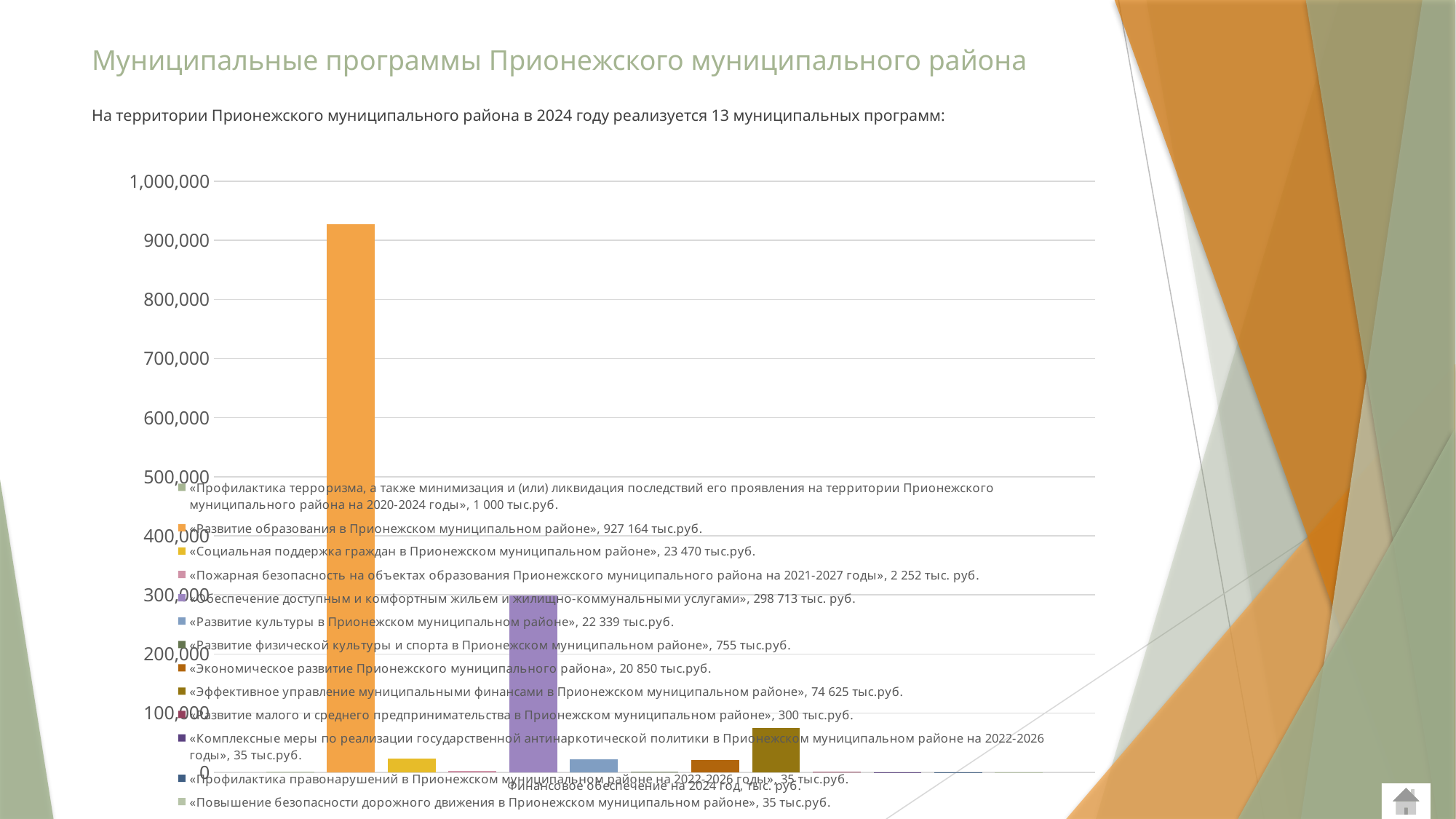
What is the title of the slide containing the chart? Муниципальные программы Прионежского муниципального района What is the financial provision for the programme «Развитие образования в Прионежском муниципальном районе»? 927 164 тыс.руб. What is the label on the x axis of the chart? Финансовое обеспечение на 2024 год, тыс. руб. What is the financial provision for the programme «Эффективное управление муниципальными финансами в Прионежском муниципальном районе»? 74 625 тыс.руб. What is the financial provision for the programme «Обеспечение доступным и комфортным жильем и жилищно-коммунальными услугами»? 298 713 тыс. руб. Is the bar for «Развитие образования в Прионежском муниципальном районе» greater or less than 900,000? greater What is the difference between the financial provision for «Развитие образования» (927 164) and «Обеспечение доступным и комфортным жильем» (298 713)? 628 451 тыс.руб. What is the financial provision for the programme «Социальная поддержка граждан в Прионежском муниципальном районе»? 23 470 тыс.руб. Which has the larger financial provision: «Социальная поддержка граждан» or «Развитие культуры»? «Социальная поддержка граждан» Which programme has the highest financial provision for 2024? «Развитие образования в Прионежском муниципальном районе» How many series does the legend list? 13 What kind of chart is shown on the slide? bar chart